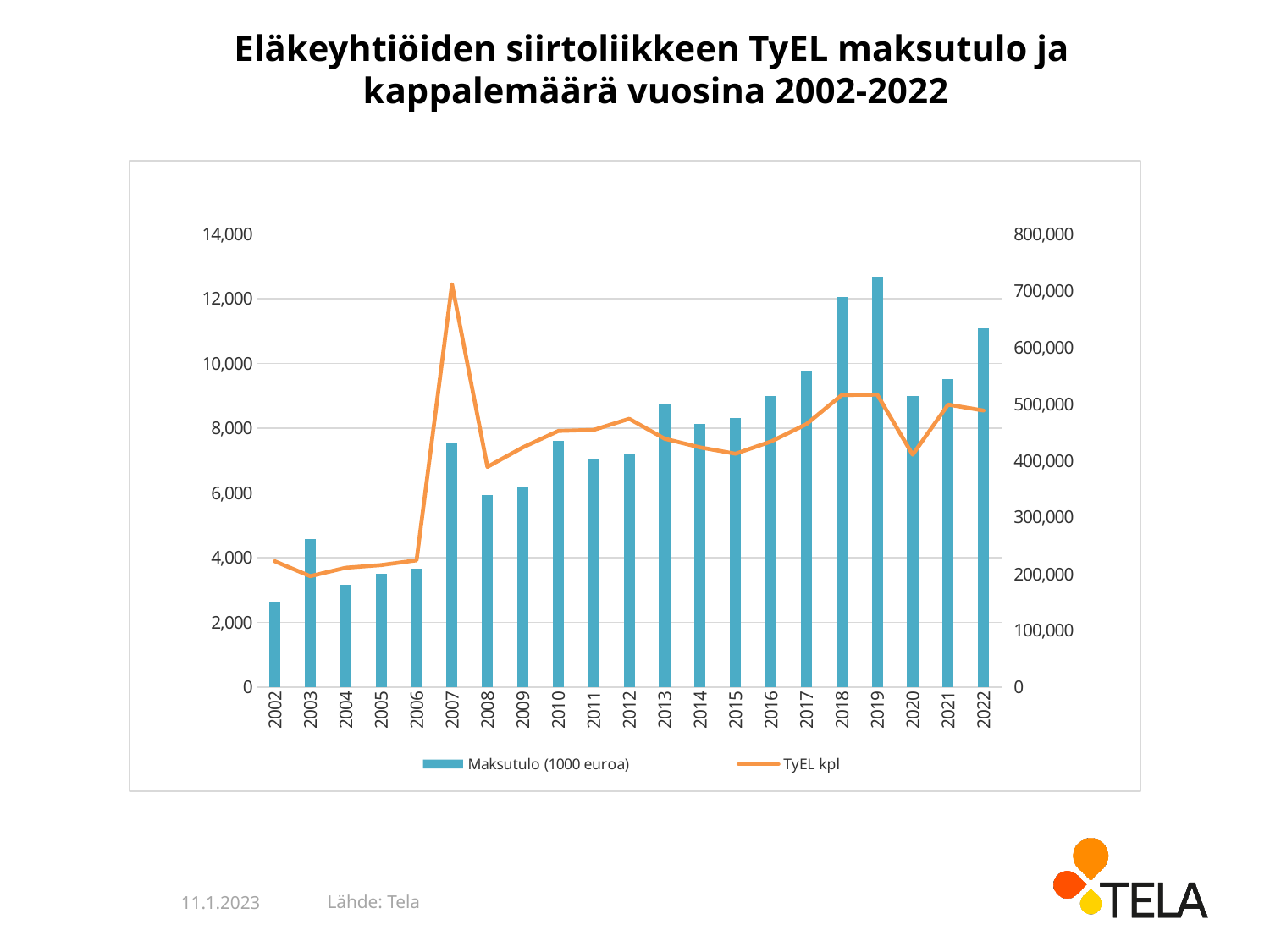
Is the TyEL kpl value for 2007 greater or less than 600,000? greater Which year has the larger Maksutulo (1000 euroa) bar, 2017 or 2018? 2018 How many years are shown on the x axis of the chart? 21 In which year is the TyEL kpl line at its lowest? 2003 What kind of chart is shown on the slide? A combined bar and line chart What are the two series named in the chart legend? Maksutulo (1000 euroa) and TyEL kpl Which year has the highest Maksutulo (1000 euroa) bar? 2019 Is the Maksutulo (1000 euroa) value for 2019 greater or less than 12,000? greater Which year has the lowest Maksutulo (1000 euroa) bar? 2002 Is the TyEL kpl value for 2020 greater or less than 500,000? less How many series does the chart legend list? 2 In which year does the TyEL kpl line reach its peak? 2007